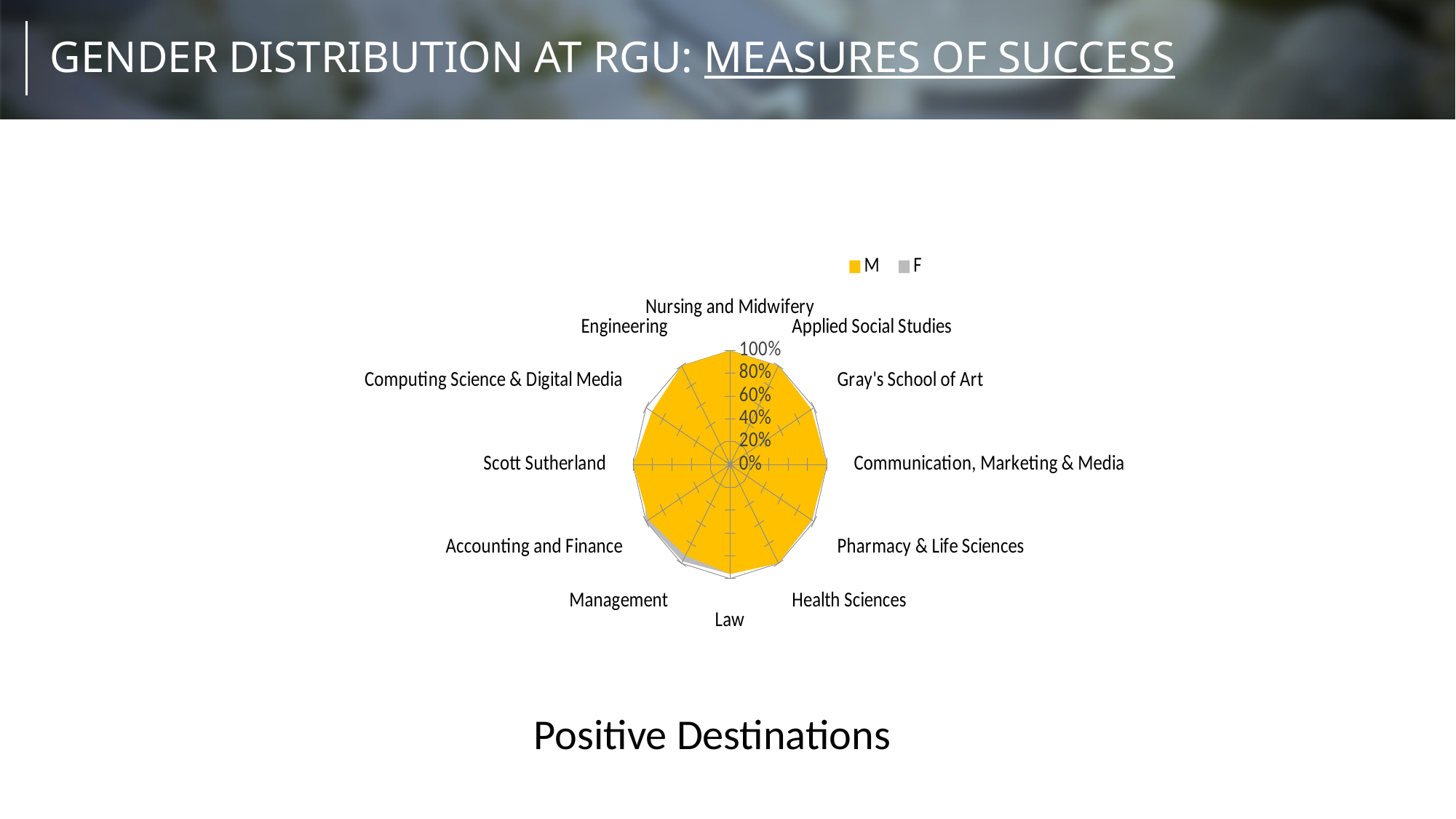
What are the two series named in the legend? M and F How many categories (schools) are plotted on the radar chart? 12 What colour represents the M series? yellow Is the M value for Law greater or less than 60%? greater Is the M value for Engineering greater or less than 60%? greater How many series does the legend list? 2 What kind of chart is shown on the slide? radar chart Is the M value for Scott Sutherland greater or less than 40%? greater What is the maximum value shown on the radar chart's axis? 100%